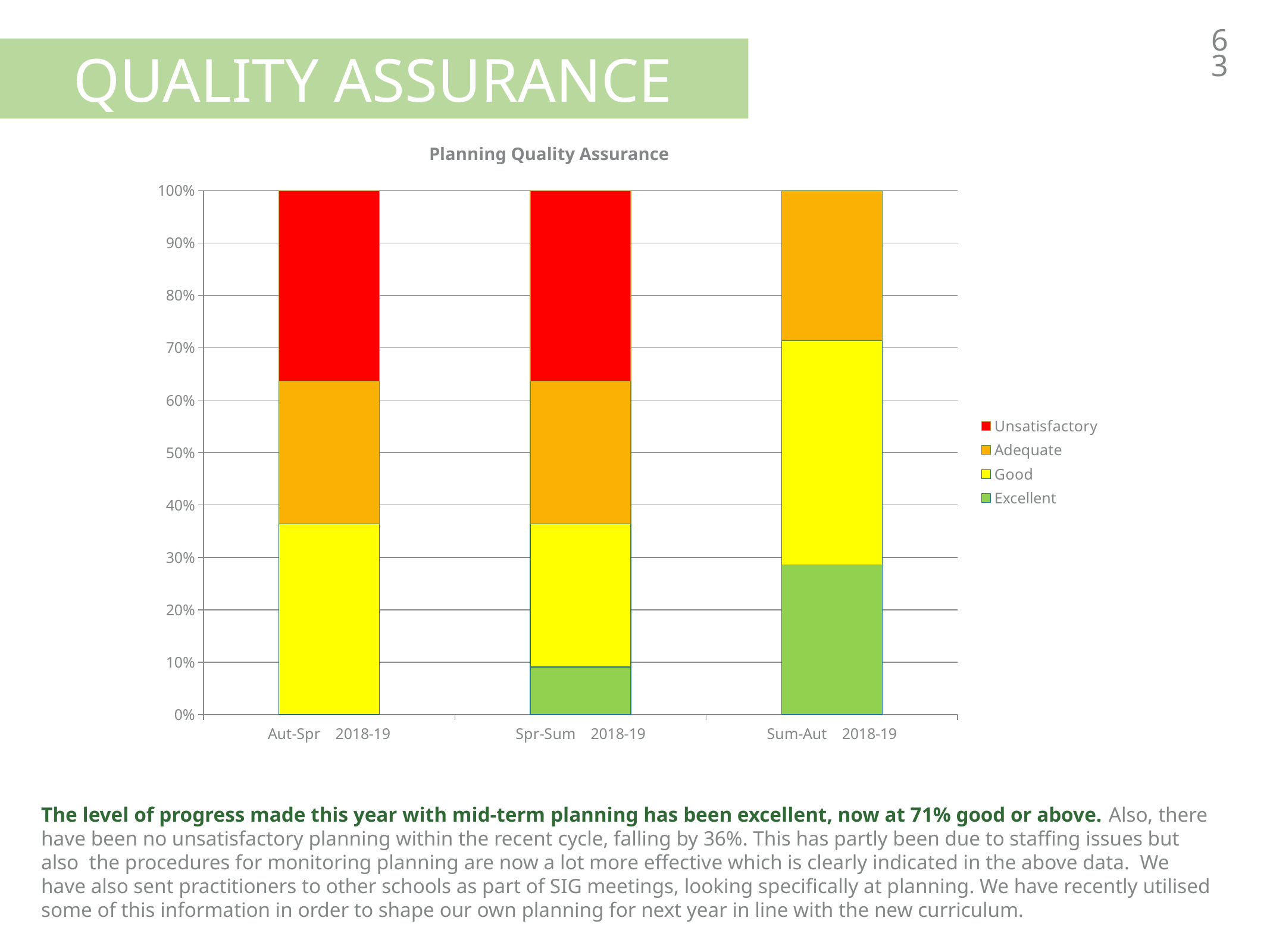
How many categories are shown on the x axis? 3 Which colour represents the Unsatisfactory series in the legend? Red Is the Excellent value for Spr-Sum 2018-19 greater or less than 20%? less Does the Excellent segment rise or fall across the categories from left to right? Rise How many series does the legend list? 4 Is the Excellent value for Sum-Aut 2018-19 greater or less than 20%? greater What is the total of the stacked bar for Sum-Aut 2018-19? 100% Which category has the largest Excellent segment? Sum-Aut 2018-19 Is the Excellent segment larger for Sum-Aut 2018-19 or Spr-Sum 2018-19? Sum-Aut 2018-19 What is the title of the chart? Planning Quality Assurance What kind of chart is shown on the slide? Stacked bar chart